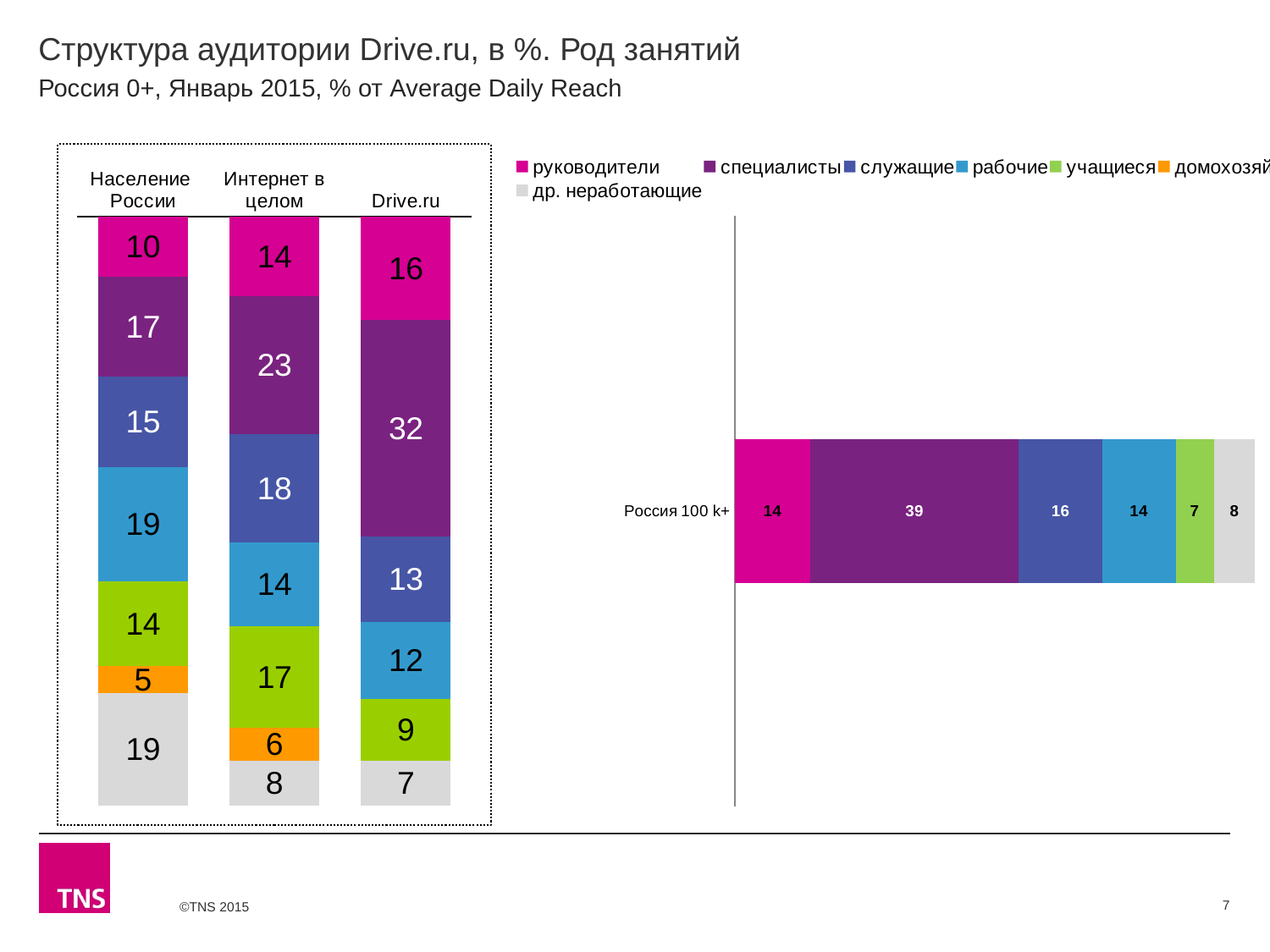
In the left stacked bar chart, what is the value of the специалисты segment for Drive.ru? 32 In the right chart (Россия 100 k+), what is the value of the специалисты segment? 39 In the left stacked bar chart, what is the difference between the специалисты values for Drive.ru and Население России? 22 In the left stacked bar chart, what is the value of the учащиеся segment for Интернет в целом? 17 In the left stacked bar chart, which of the three bars has the smallest др. неработающие segment? Drive.ru How many bars are shown in the left stacked bar chart? 3 In the right chart (Россия 100 k+), what is the value of the служащие segment? 16 In the left stacked bar chart, is the рабочие value larger for Население России or for Drive.ru? Население России What type of chart is the right chart labelled Россия 100 k+? Stacked bar chart How many entries does the legend on the slide list? 7 In the left stacked bar chart, which of the three bars has the largest специалисты segment? Drive.ru In the left stacked bar chart, what is the value of the руководители segment for Население России? 10